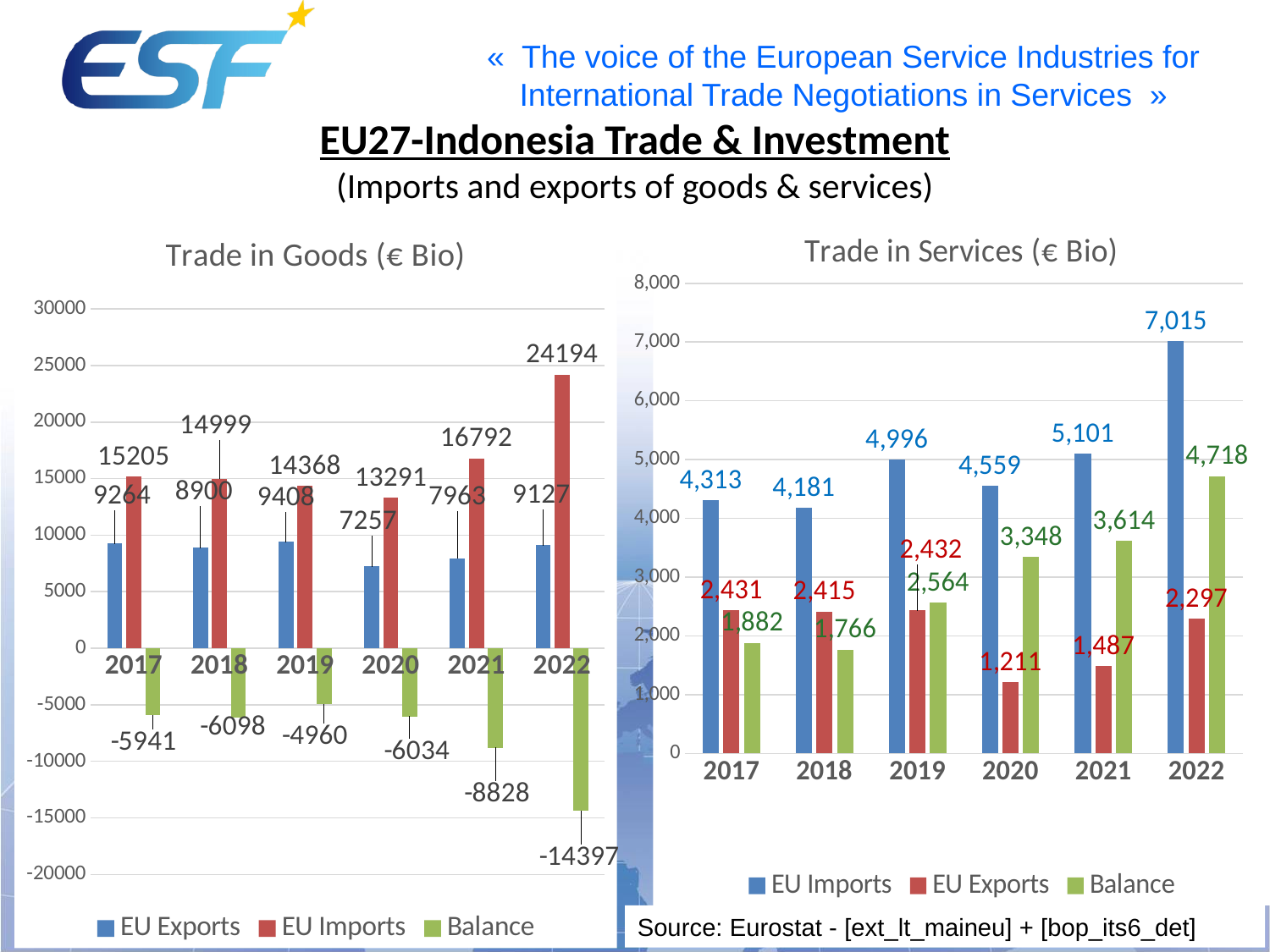
In the Trade in Services chart, what is the value of EU Imports in 2022? 7,015 How many series does the legend of the Trade in Goods chart list? 3 In the Trade in Services chart, what is the difference between the Balance in 2022 and the Balance in 2021? 1,104 In the Trade in Goods chart, what is the value of EU Imports in 2022? 24194 In the Trade in Services chart, what is the Balance in 2020? 3,348 In the Trade in Goods chart, is the EU Exports value for 2019 greater or less than 10000? less In the Trade in Services chart, which year has the lowest EU Exports value? 2020 In the Trade in Goods chart, what is the difference between EU Imports and EU Exports in 2021? 8829 How many years are shown on the x axis of the Trade in Services chart? 6 In the Trade in Goods chart, which year has the lowest Balance? 2022 In the Trade in Services chart, is EU Imports in 2019 larger or smaller than EU Imports in 2020? larger In the Trade in Goods chart, what is the value of EU Exports in 2020? 7257